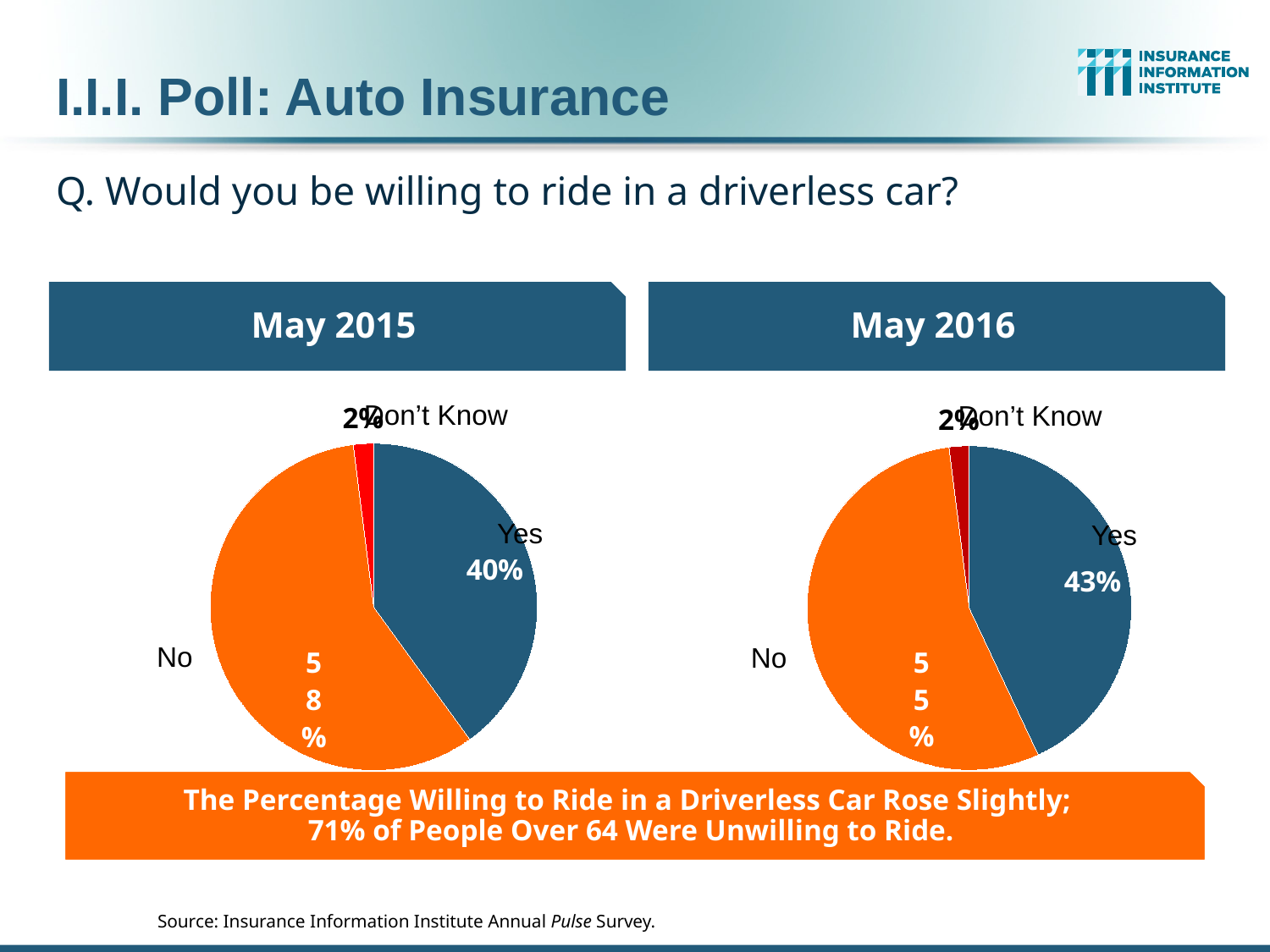
In the May 2016 chart, which response has the smallest share? Don't Know In the May 2016 chart, what percentage answered Yes? 43% How many slices does the May 2015 pie chart have? 3 What colour is the No slice in the May 2015 chart? Orange In the May 2015 chart, which response has the largest share? No In the May 2016 chart, what percentage answered No? 55% Which chart shows a larger Yes percentage, May 2015 or May 2016? May 2016 In the May 2015 chart, what percentage answered No? 58% In the May 2015 chart, what percentage answered Yes? 40% In the May 2016 chart, what is the difference between the No and Yes percentages? 12% What type of chart is used for the May 2016 data? Pie chart In the May 2016 chart, what percentage answered Don't Know? 2%